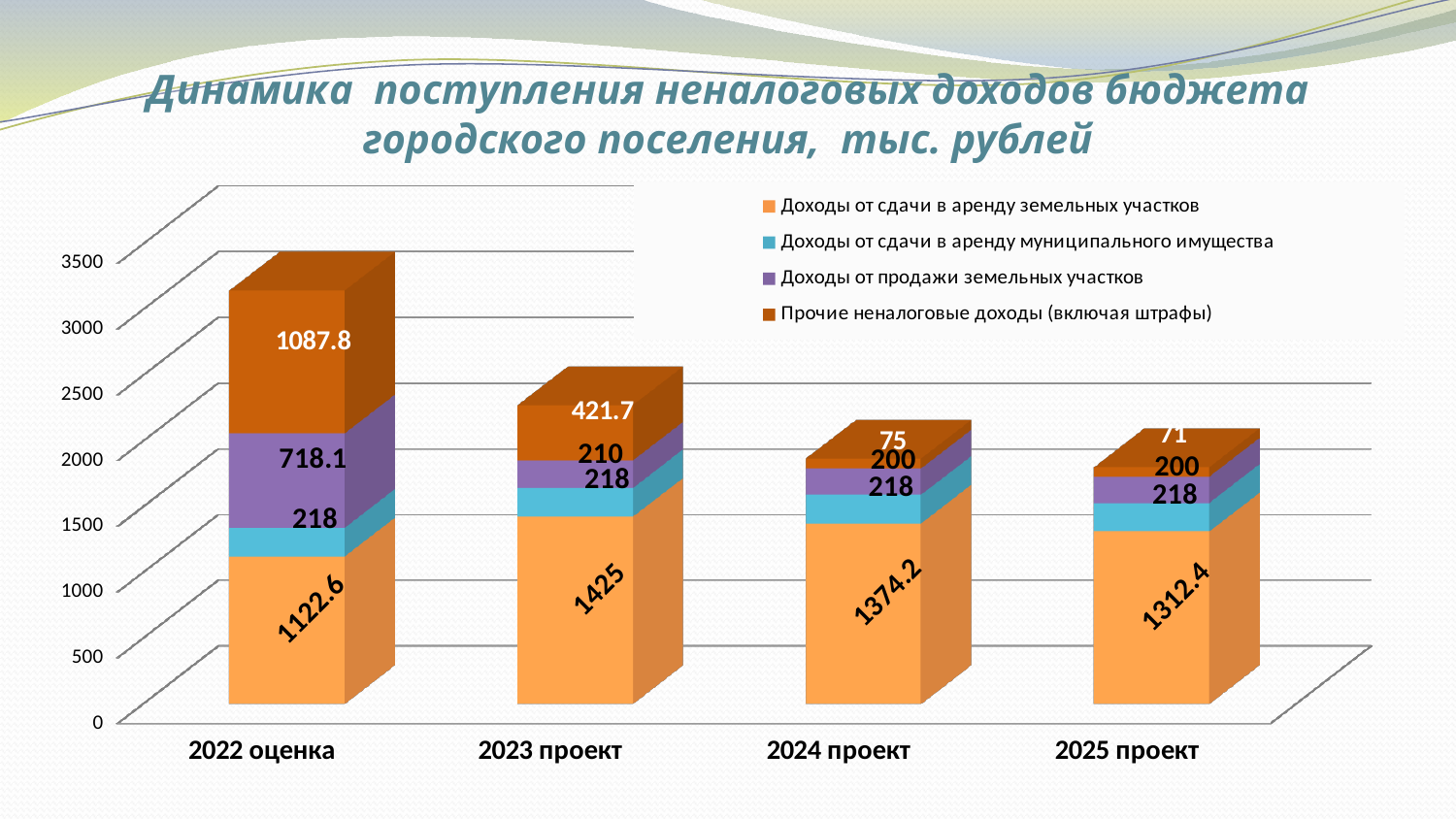
What is the value of Доходы от сдачи в аренду земельных участков for 2023 проект? 1425 What kind of chart is shown on the slide? stacked bar chart How many series does the legend list? 4 Is the total of the stacked bar for 2022 оценка greater or less than 3000? greater What is the value of Прочие неналоговые доходы (включая штрафы) for 2022 оценка? 1087.8 What is the value of Доходы от продажи земельных участков for 2024 проект? 200 What is the total of the stacked bar for 2024 проект? 1867.2 Which category has the lowest value for Прочие неналоговые доходы (включая штрафы)? 2025 проект How many categories are shown on the x axis? 4 What is the difference between Доходы от продажи земельных участков for 2022 оценка and 2023 проект? 508.1 What is the value of Прочие неналоговые доходы (включая штрафы) for 2025 проект? 71 Which category has the highest value for Доходы от сдачи в аренду земельных участков? 2023 проект